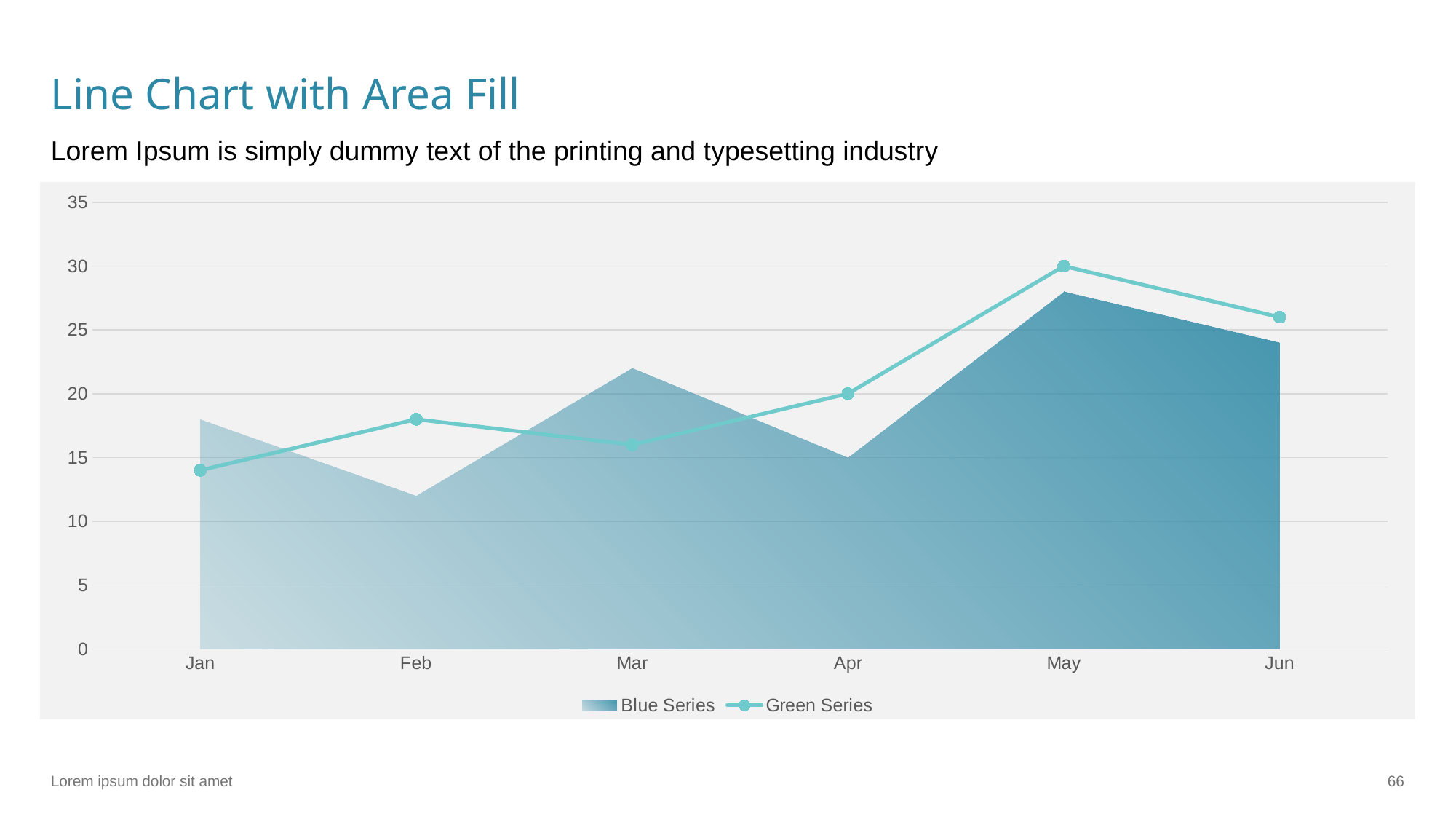
Is the value of the Green Series in Jun greater or less than 25? greater Does the Green Series rise or fall from Apr to May? rise What kind of chart is shown on the slide? Line chart with area fill In which month is the Blue Series lowest? Feb In Mar, which series has the larger value, Blue Series or Green Series? Blue Series Is the value of the Blue Series in Feb greater or less than 15? less How many months are shown on the x axis? 6 In which month is the Green Series highest? May What is the value of the Green Series in Apr? 20 What is the value of the Green Series in May? 30 In which month is the Blue Series highest? May How many series does the legend list? 2